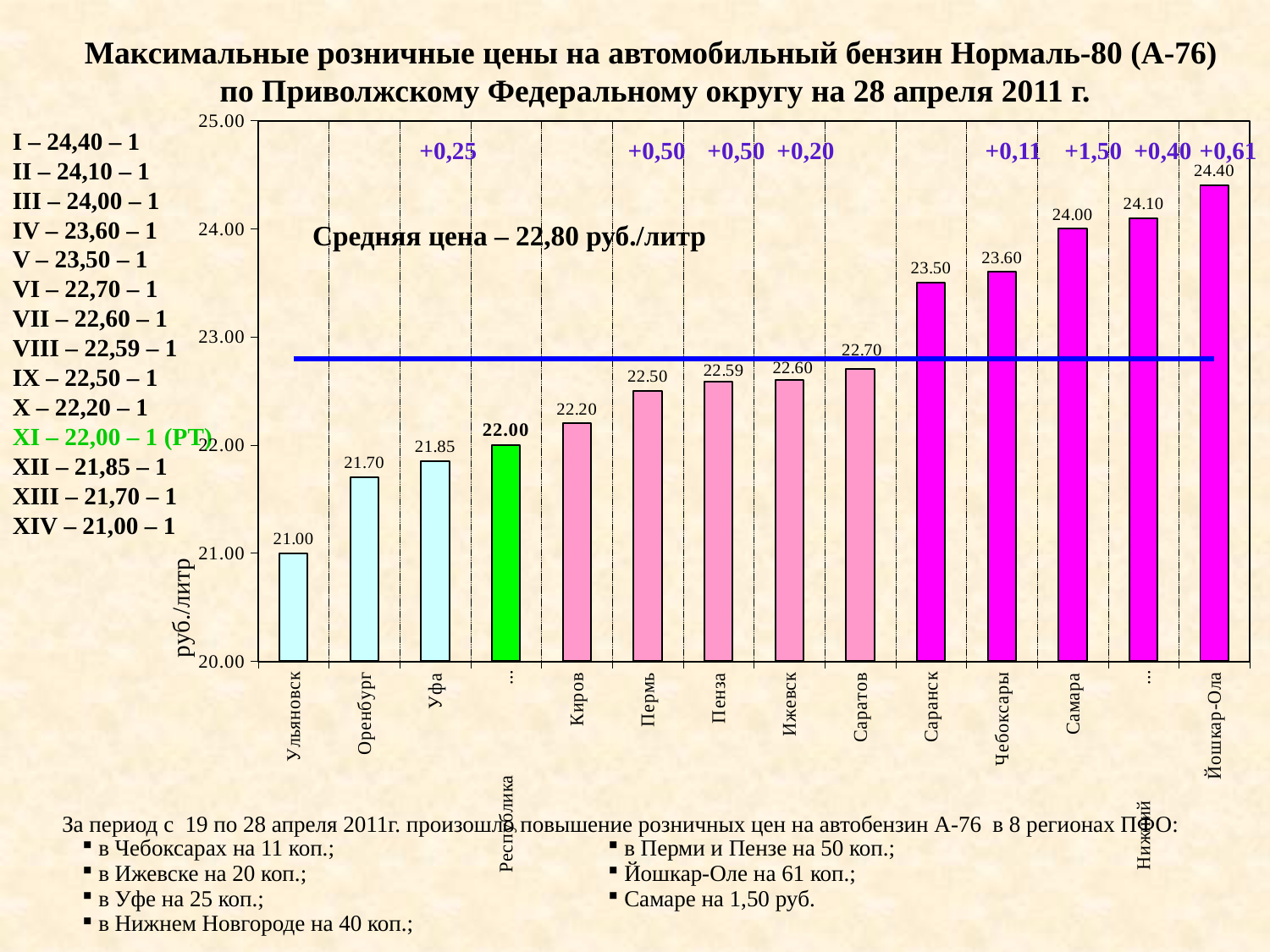
Which category has the lowest value? Ульяновск What is the value for Саранск? 23.50 Do the values rise or fall from left to right along the x axis? rise What is the difference between the values for Самара and Киров? 1.80 What kind of chart is shown on the slide? bar chart What is the value for Пенза? 22.59 What is the value for Ульяновск? 21.00 Which category has the highest value? Йошкар-Ола How many bars are shown in the chart? 14 Which is larger, the value for Чебоксары or the value for Саратов? Чебоксары What is the value for Йошкар-Ола? 24.40 Is the value for Уфа greater or less than 22.00? less